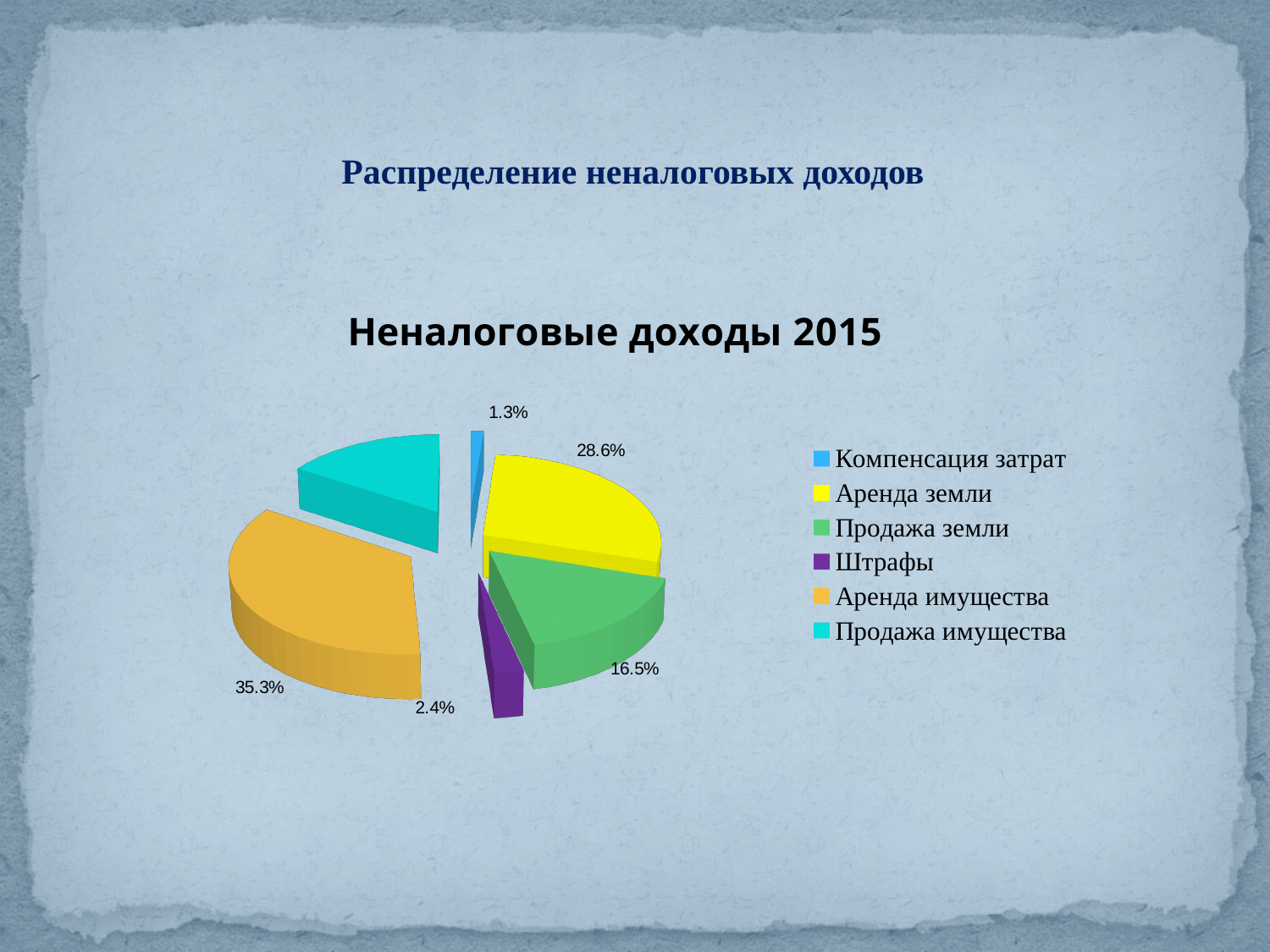
Which category has the smallest share of the pie? Компенсация затрат What kind of chart is shown on the slide? pie chart What share of the pie is Продажа земли? 16.5% What is the title of the chart? Неналоговые доходы 2015 Which category has the largest share of the pie? Аренда имущества What share of the pie is Штрафы? 2.4% What share of the pie is Аренда земли? 28.6% What share of the pie is Компенсация затрат? 1.3% How many categories does the legend list? 6 What share of the pie is Аренда имущества? 35.3% What is the difference in percentage points between Аренда имущества and Аренда земли? 6.7 Which is larger, the share for Продажа земли or the share for Штрафы? Продажа земли